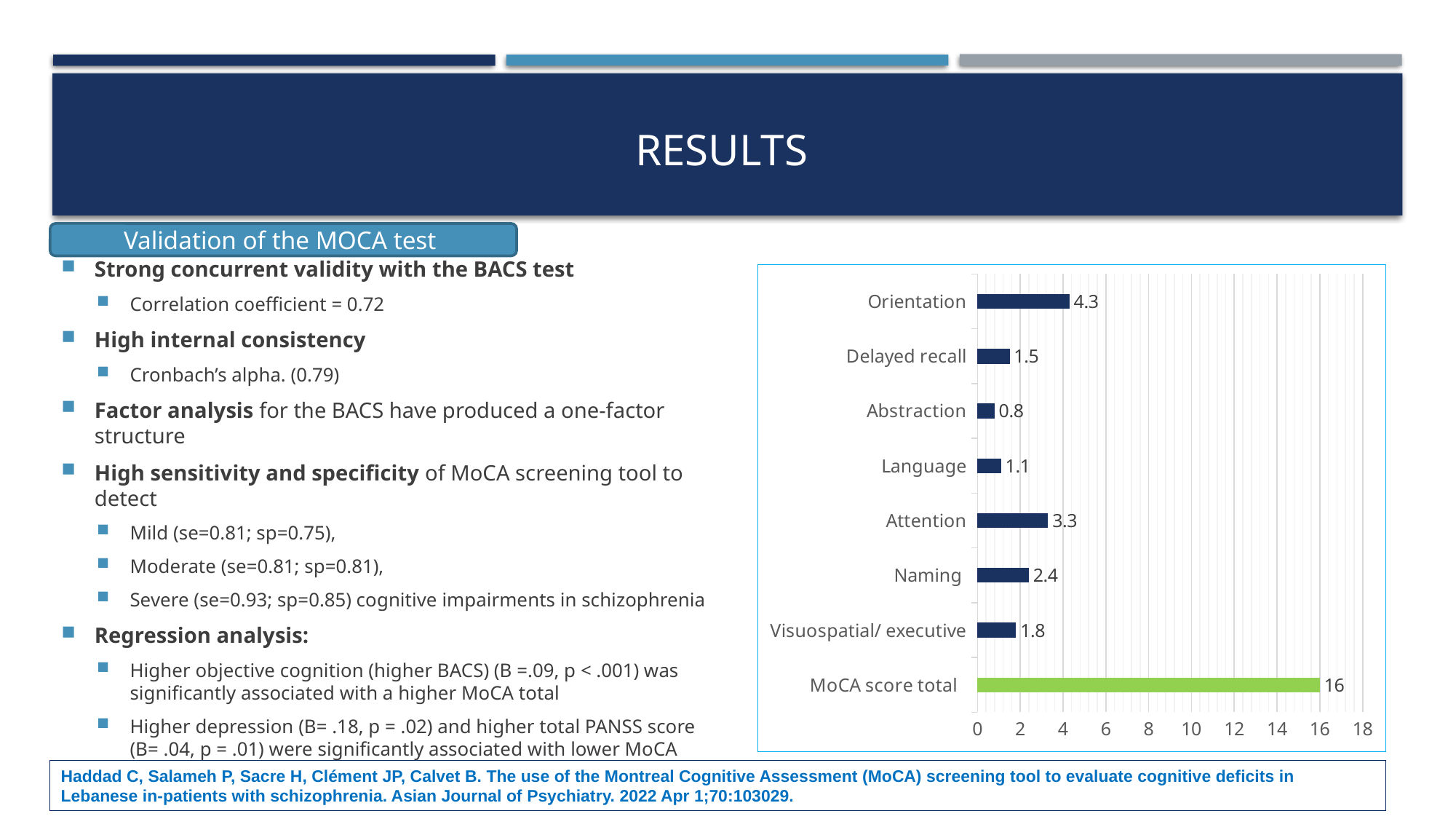
Which category has the lowest value? Abstraction What is the value for MoCA score total? 16 Which category has the highest value? MoCA score total What is the value for Visuospatial/ executive? 1.8 Which is larger, the value for Naming or the value for Language? Naming What kind of chart is shown on the slide? Bar chart What is the value for Attention? 3.3 How many categories are shown on the chart? 8 Is the value for Attention greater or less than 2? greater What is the difference between the values for Orientation and Delayed recall? 2.8 What is the value for Orientation? 4.3 Which bar is shown in green rather than dark blue? MoCA score total